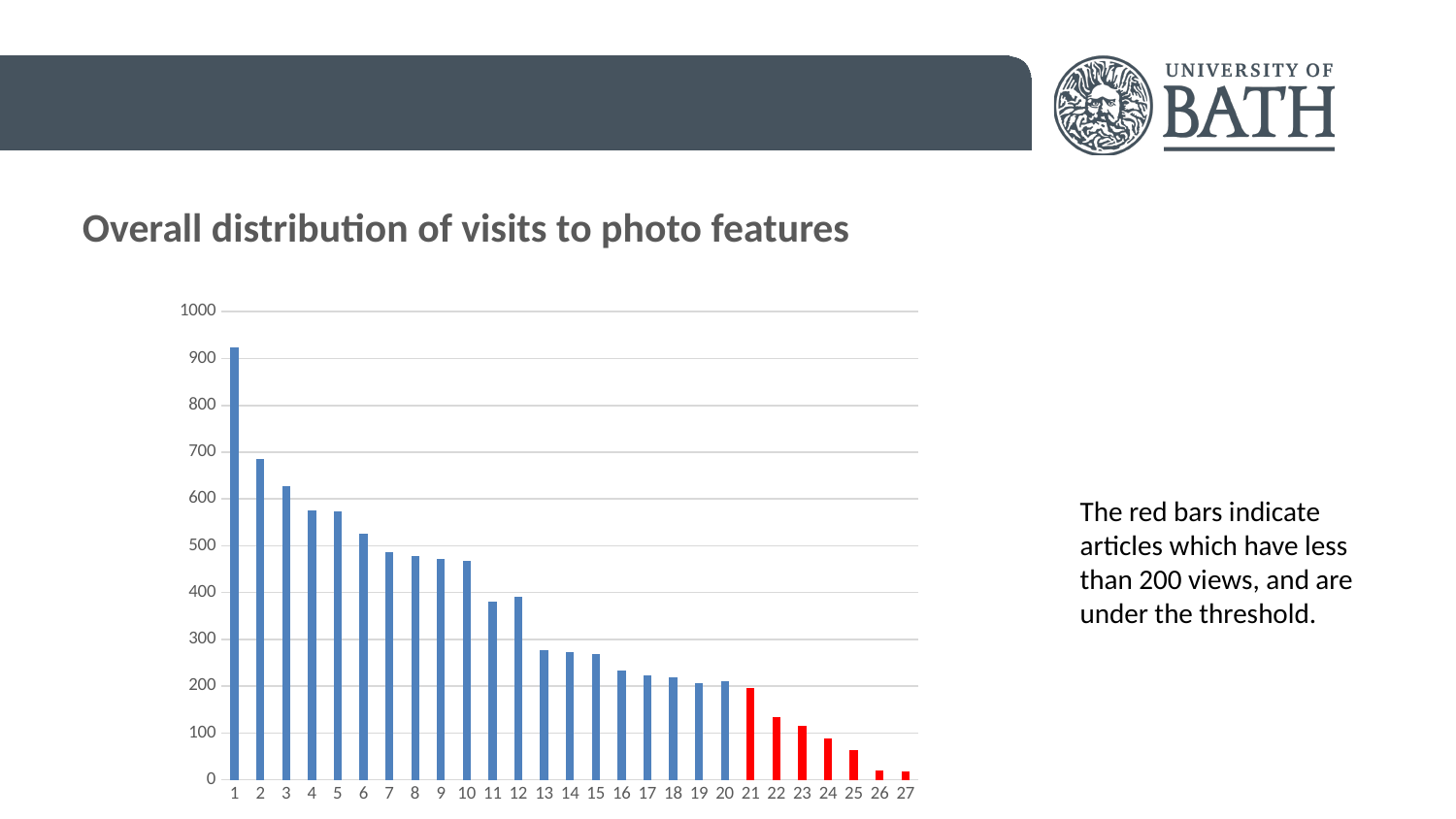
Is the value for category 1 greater or less than 900? greater Is the value for category 6 greater or less than 500? greater Is the value for category 22 greater or less than 100? greater What kind of chart is shown on the slide? bar chart What is the title of the chart? Overall distribution of visits to photo features Which category has the highest value in the chart? 1 How many categories are plotted along the x axis of the chart? 27 Do the values generally rise or fall from left to right along the x axis? fall How many bars in the chart are coloured red? 7 Which is larger, the value for category 1 or the value for category 2? category 1